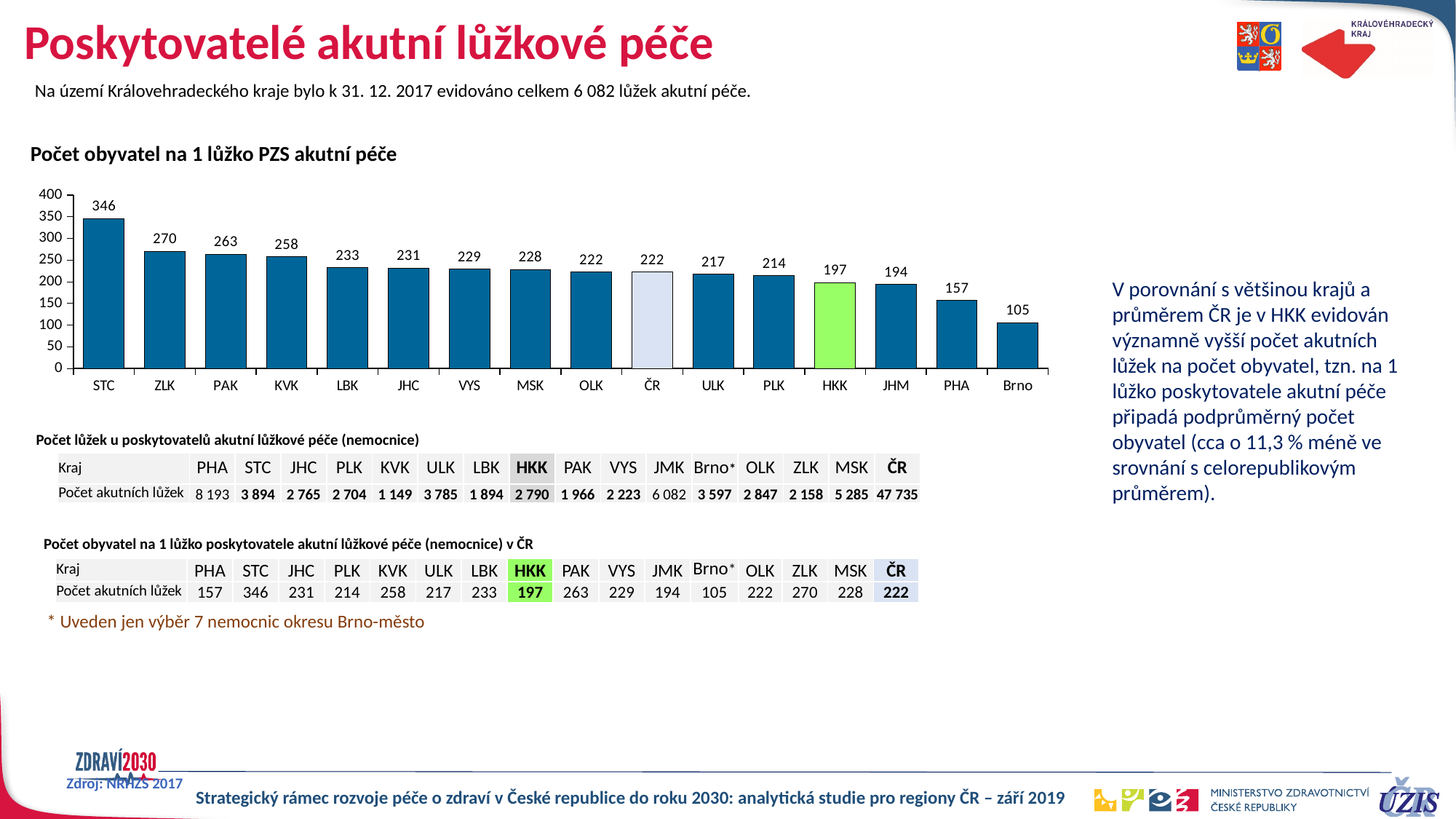
What is the value for ČR in the chart? 222 Which category has the highest value in the chart? STC What is the value for STC in the chart? 346 Which category has the lowest value in the chart? Brno What is the difference between the values for STC and Brno in the chart? 241 How many categories are shown on the x axis of the chart? 16 What is the value for HKK in the chart 'Počet obyvatel na 1 lůžko PZS akutní péče'? 197 What is the difference between the values for ČR and HKK in the chart? 25 What kind of chart is shown on the slide? bar chart Do the values in the chart rise or fall from left to right along the x axis? fall Is the value for JHM in the chart greater or less than 200? less Which has a larger value in the chart, ZLK or PHA? ZLK